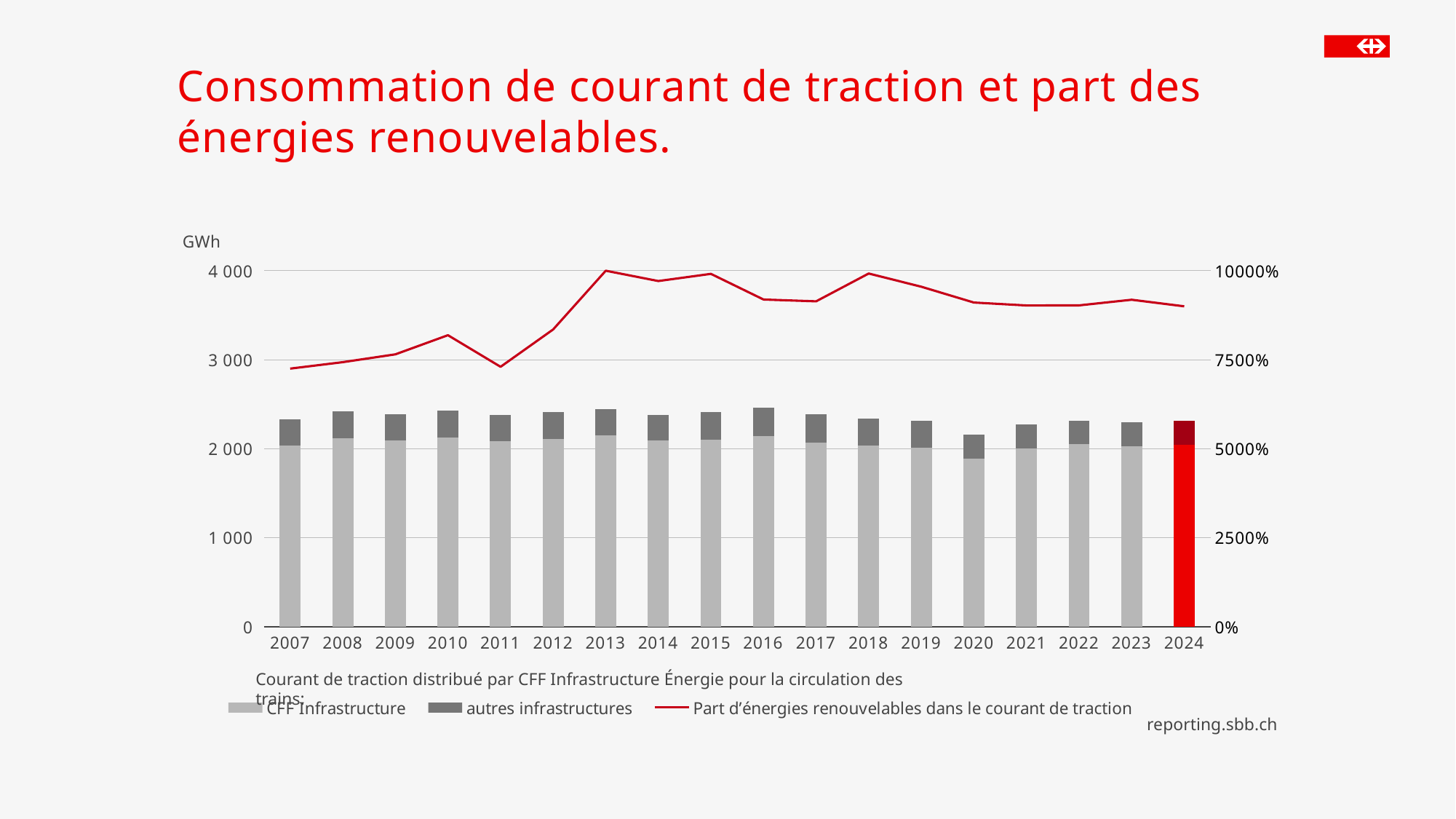
Does the renewable energy share line rise or fall between 2007 and 2013? rise Is the share of renewable energies in 2007 greater or less than 7500%? less Is the total stacked bar for 2013 greater or less than 3 000 GWh? less What unit is shown on the left vertical axis? GWh How many series does the legend list? 3 Is the total stacked bar for 2020 greater or less than 2 000 GWh? greater Which year has the lowest total traction current consumption (shortest stacked bar)? 2020 How many years are shown on the x axis of the chart? 18 Which series is drawn as a red line in the legend? Part d’énergies renouvelables dans le courant de traction What kind of chart is shown on the slide? A combined bar and line chart (stacked bars with a line) Which is larger, the total stacked bar for 2016 or for 2020? 2016